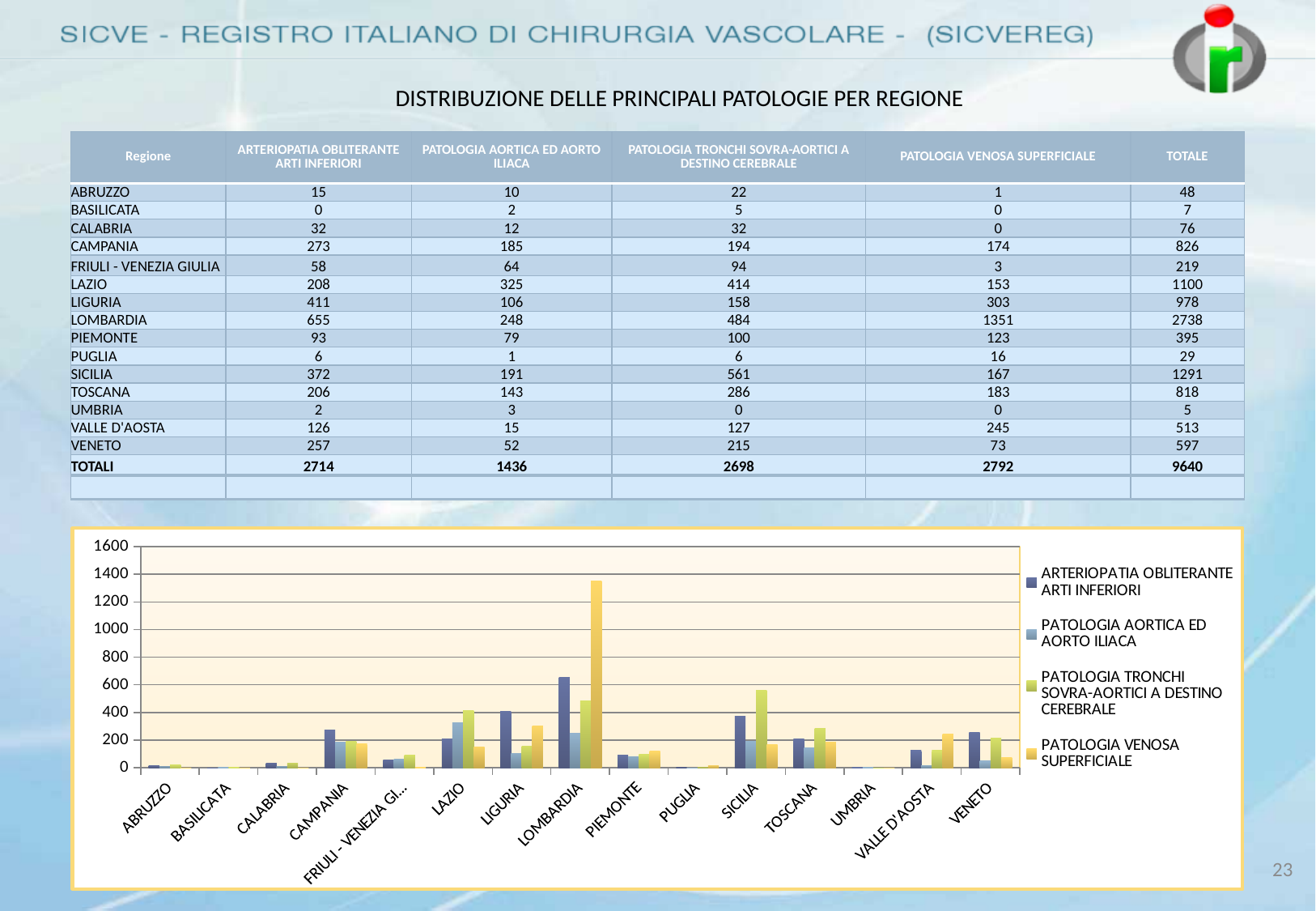
What is the TOTALE for LOMBARDIA? 2738 Which region has the lowest TOTALE? UMBRIA Which region has the highest bar for PATOLOGIA VENOSA SUPERFICIALE? LOMBARDIA Which region has the larger value for ARTERIOPATIA OBLITERANTE ARTI INFERIORI, LAZIO or LIGURIA? LIGURIA Is the value for LOMBARDIA in PATOLOGIA VENOSA SUPERFICIALE greater or less than 1200? greater What kind of chart is shown on the slide? bar chart What is the difference between LOMBARDIA and LIGURIA for ARTERIOPATIA OBLITERANTE ARTI INFERIORI? 244 What colour represents PATOLOGIA VENOSA SUPERFICIALE in the chart? yellow What is the value for SICILIA in PATOLOGIA TRONCHI SOVRA-AORTICI A DESTINO CEREBRALE? 561 How many series does the chart legend list? 4 Is the value for SICILIA in PATOLOGIA TRONCHI SOVRA-AORTICI A DESTINO CEREBRALE greater or less than 400? greater How many regions are shown along the x axis of the chart? 15